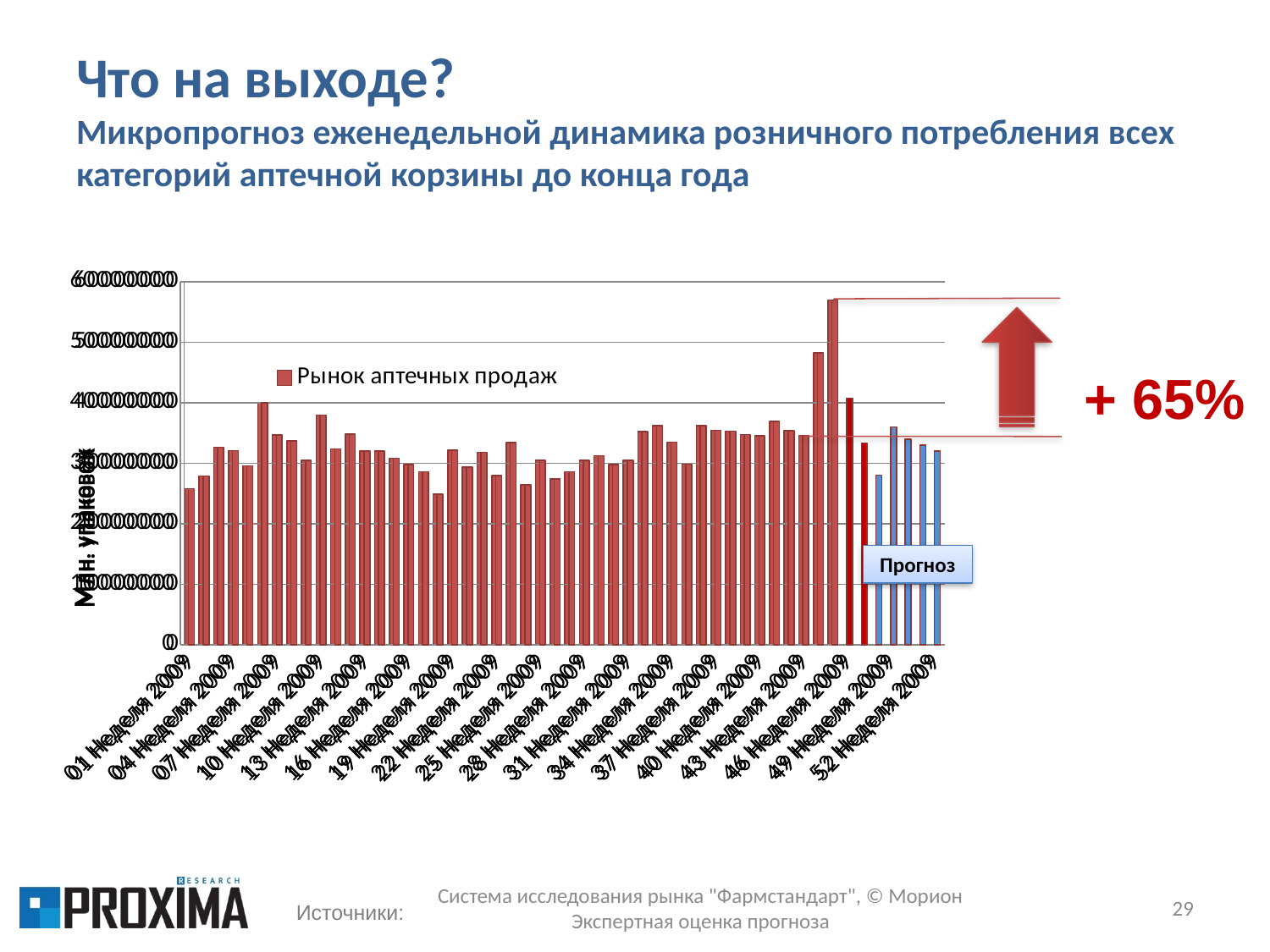
Do the values generally rise or fall from 01 неделя 2009 to 46 неделя 2009? rise Which is larger, the value for 01 неделя 2009 or the value for 46 неделя 2009? 46 неделя 2009 What is the name of the series shown in the chart legend? Рынок аптечных продаж Is the value for 01 неделя 2009 greater or less than 30000000? less Is the value for 10 неделя 2009 greater or less than 30000000? greater How many series does the chart legend list? 1 Which is larger, the value for 10 неделя 2009 or the value for 19 неделя 2009? 10 неделя 2009 What percentage change is annotated next to the red arrow on the chart? + 65% Is the value for 04 неделя 2009 greater or less than 40000000? less What kind of chart is shown on the slide? bar chart